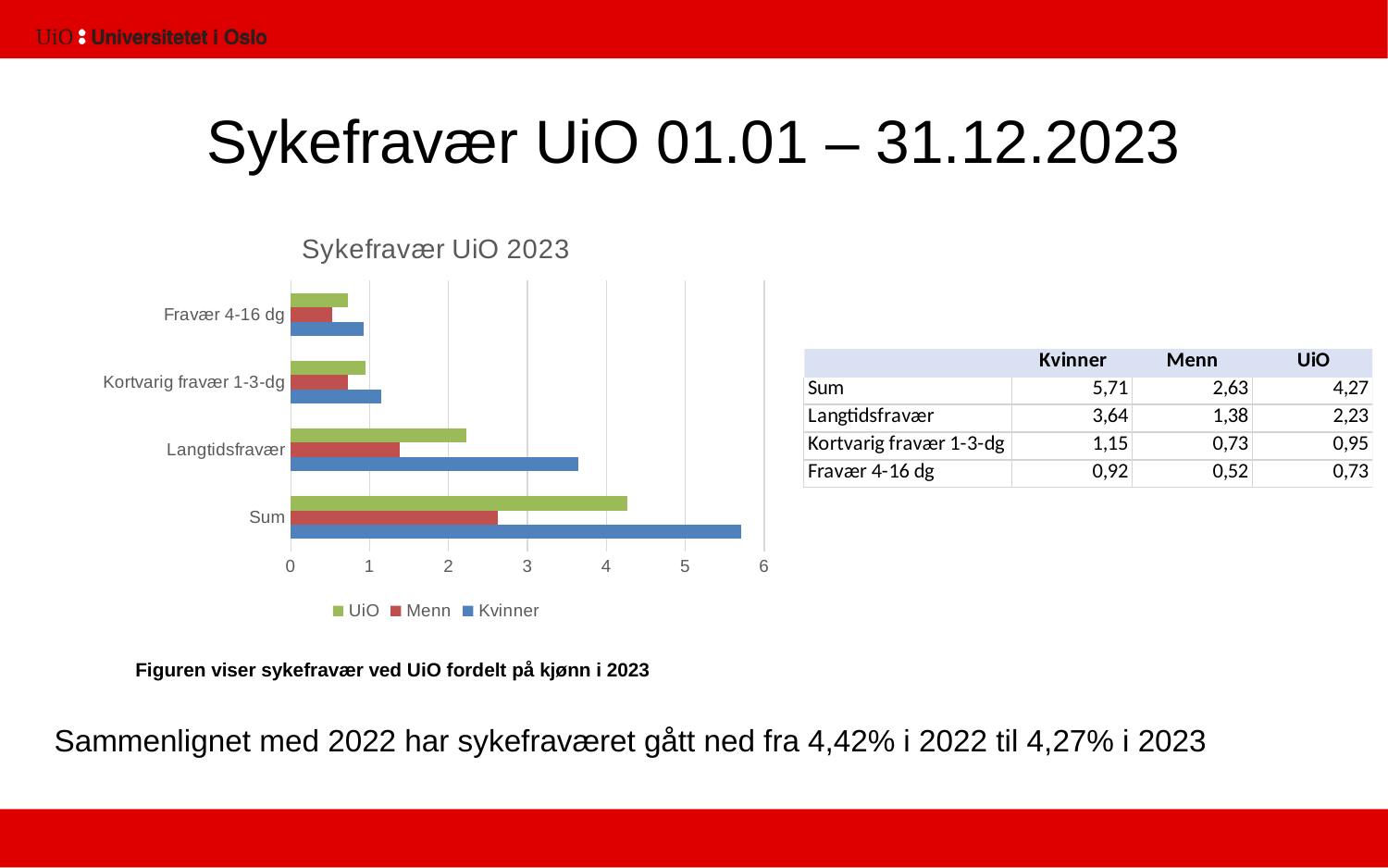
Which category has the highest value for Kvinner? Sum What kind of chart is shown on the slide? bar chart How many series does the chart legend list? 3 What is the value for Kvinner in the Sum category? 5,71 What is the title of the chart? Sykefravær UiO 2023 How many categories are shown on the chart's vertical axis? 4 Which category has the lowest value for Menn? Fravær 4-16 dg What is the value for UiO in the Kortvarig fravær 1-3-dg category? 0,95 What is the difference between the Kvinner and Menn values in the Sum category? 3,08 Which is larger in the Langtidsfravær category, the value for Kvinner or the value for UiO? Kvinner What is the value for Menn in the Langtidsfravær category? 1,38 Is the value for Kvinner in the Sum category greater or less than 5? greater